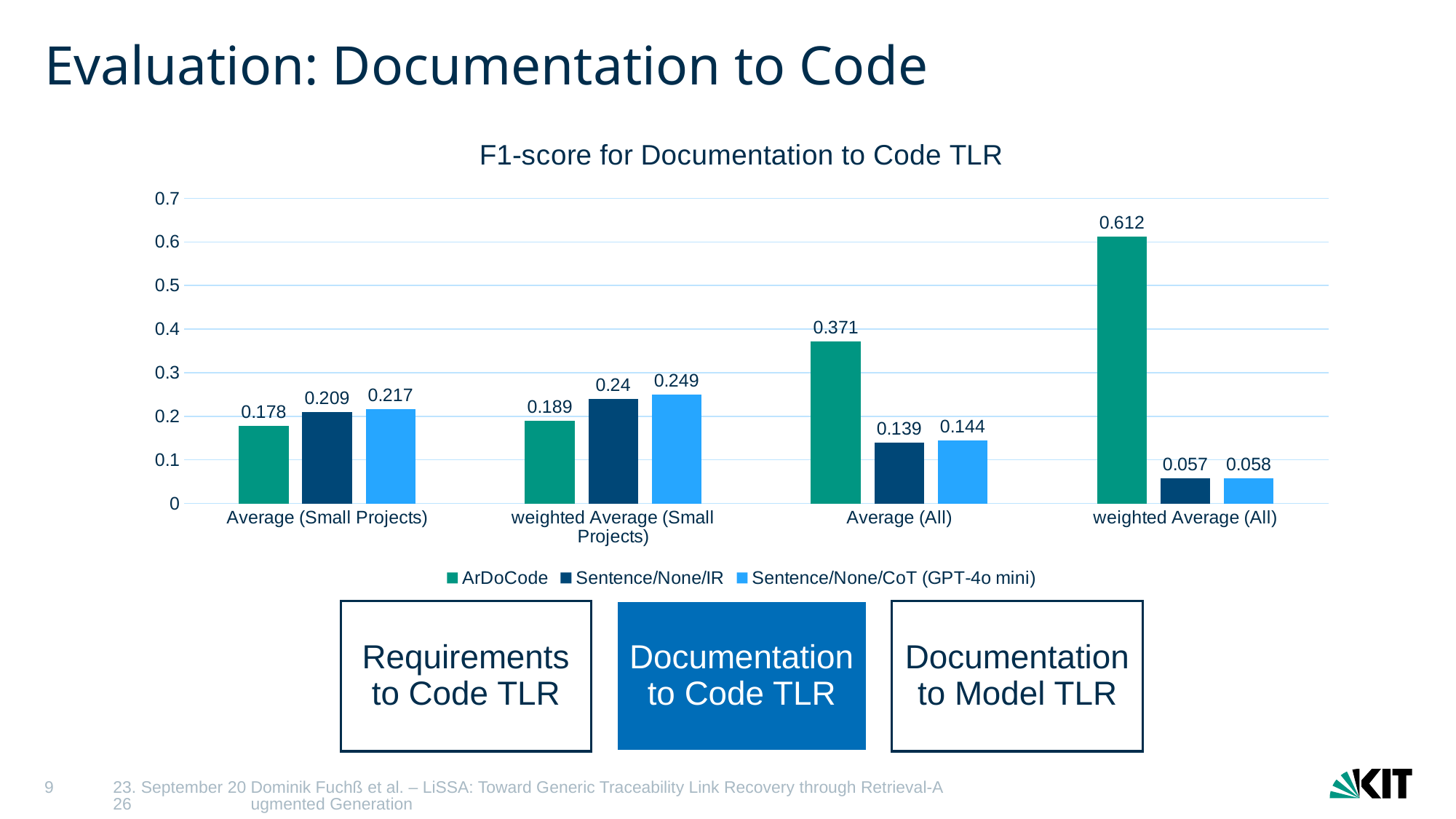
How many series does the legend list? 3 What is the F1-score of Sentence/None/CoT (GPT-4o mini) for weighted Average (Small Projects)? 0.249 For Average (Small Projects), which is larger: the ArDoCode F1-score or the Sentence/None/CoT (GPT-4o mini) F1-score? Sentence/None/CoT (GPT-4o mini) Which category has the highest ArDoCode F1-score? weighted Average (All) How many categories are shown on the x axis? 4 What is the title of the chart? F1-score for Documentation to Code TLR What kind of chart is shown on the slide? bar chart What is the F1-score of ArDoCode for weighted Average (All)? 0.612 Which category has the lowest Sentence/None/IR F1-score? weighted Average (All) What is the F1-score of Sentence/None/IR for Average (Small Projects)? 0.209 What is the difference between the ArDoCode and Sentence/None/IR F1-scores for Average (All)? 0.232 Is the ArDoCode F1-score for Average (All) greater or less than 0.3? greater